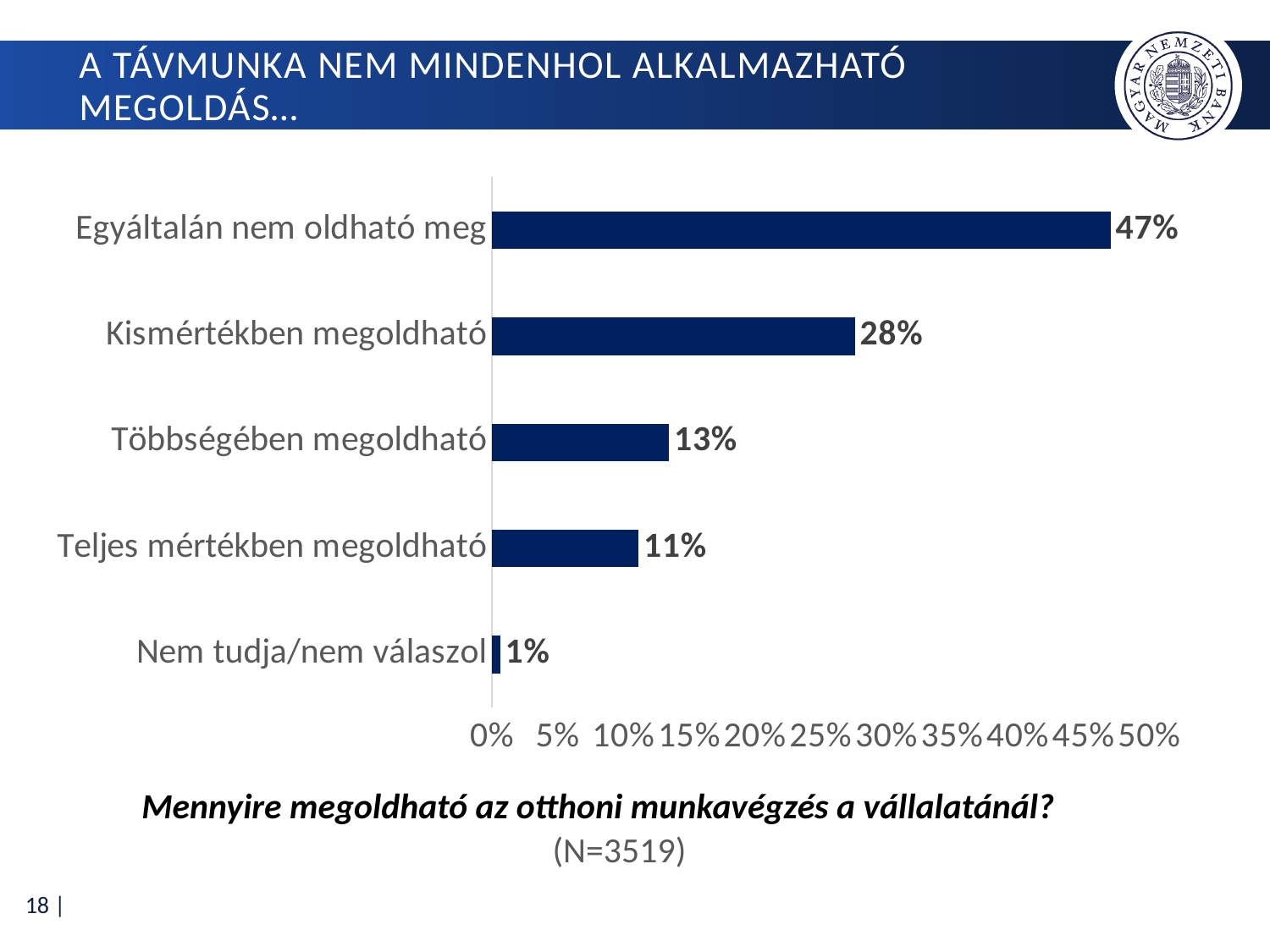
Which category has the lowest value? Nem tudja/nem válaszol Is the value for "Egyáltalán nem oldható meg" greater or less than 45%? greater What is the value for "Kismértékben megoldható"? 28% What is the difference between "Egyáltalán nem oldható meg" and "Kismértékben megoldható"? 19% How many categories are shown in the chart? 5 Which is larger: "Kismértékben megoldható" or "Többségében megoldható"? Kismértékben megoldható What is the value for "Nem tudja/nem válaszol"? 1% What kind of chart is shown on the slide? Bar chart Which category has the highest value? Egyáltalán nem oldható meg What is the difference between "Többségében megoldható" and "Teljes mértékben megoldható"? 2% What is the value for "Egyáltalán nem oldható meg"? 47% What is the value for "Teljes mértékben megoldható"? 11%